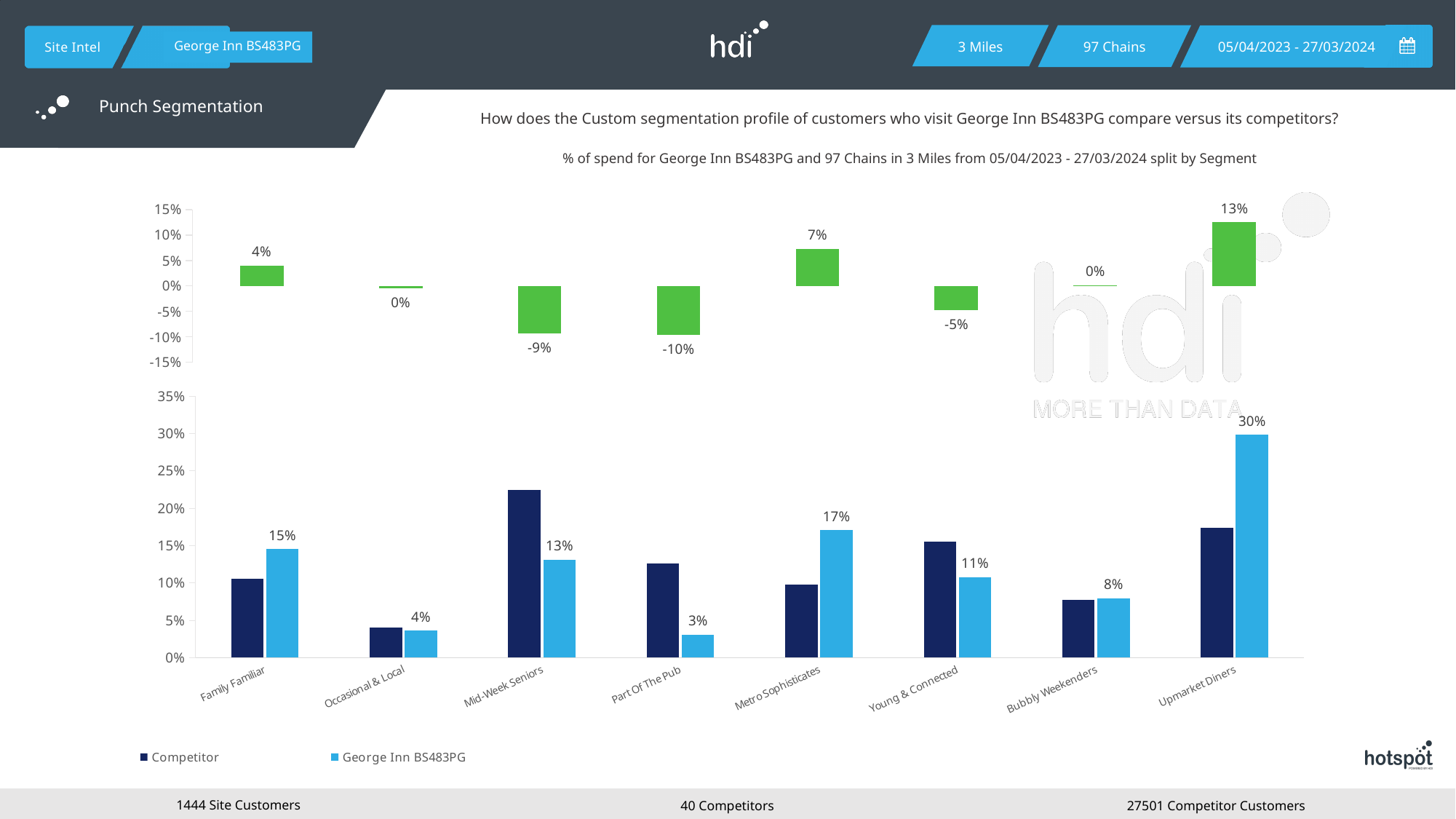
How many series does the legend of the bottom grouped bar chart list? 2 In the bottom grouped bar chart, what is the value for George Inn BS483PG in the Upmarket Diners segment? 30% In the bottom grouped bar chart, what is the value for George Inn BS483PG in the Metro Sophisticates segment? 17% What kind of chart is the bottom chart on the slide? Bar chart In the bottom grouped bar chart, which segment has the highest George Inn BS483PG value? Upmarket Diners How many segments are shown on the x axis of the bottom grouped bar chart? 8 In the top difference chart (green bars), which segment has the highest value? Upmarket Diners In the top difference chart (green bars), what is the value for Part Of The Pub? -10% In the bottom grouped bar chart, is the Competitor value for Mid-Week Seniors greater or less than 20%? greater In the bottom grouped bar chart, what is the difference between the George Inn BS483PG values for Upmarket Diners and Family Familiar? 15% In the bottom grouped bar chart, which is larger for Mid-Week Seniors: the Competitor bar or the George Inn BS483PG bar? Competitor In the bottom grouped bar chart, which segment has the lowest George Inn BS483PG value? Part Of The Pub